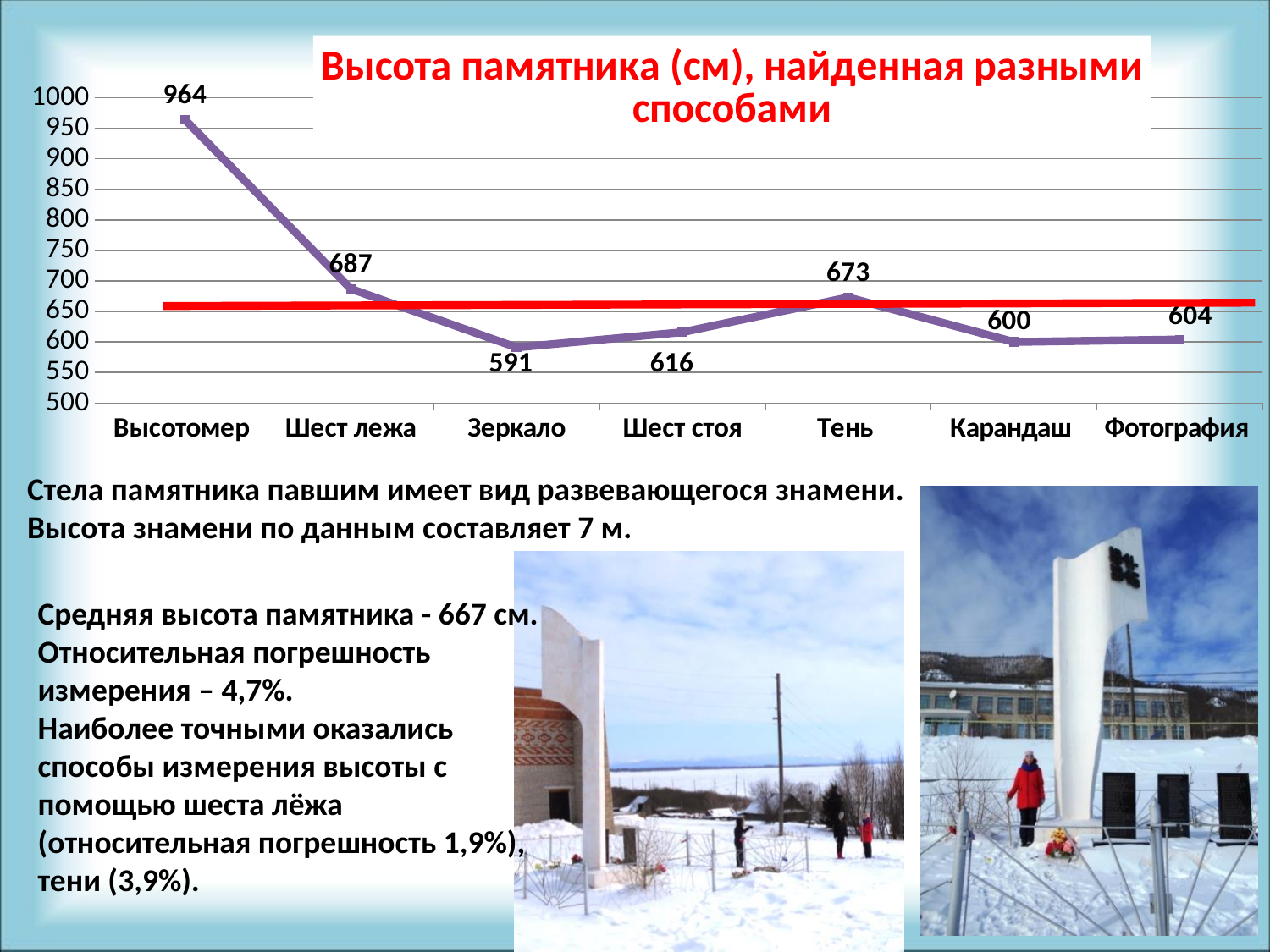
What value is shown for Тень? 673 What value is shown for Фотография? 604 What is the difference between the values for Шест стоя and Карандаш? 16 Is the value for Шест лежа greater or less than 650? greater Which method gives the highest height value? Высотомер What is the difference between the values for Высотомер and Шест лежа? 277 Which method gives the lowest height value? Зеркало Which is larger, the value for Тень or the value for Шест стоя? Тень What is the height value shown for Высотомер? 964 What type of chart is shown on the slide? line chart How many measurement methods are shown on the x axis? 7 What value is plotted for Зеркало? 591